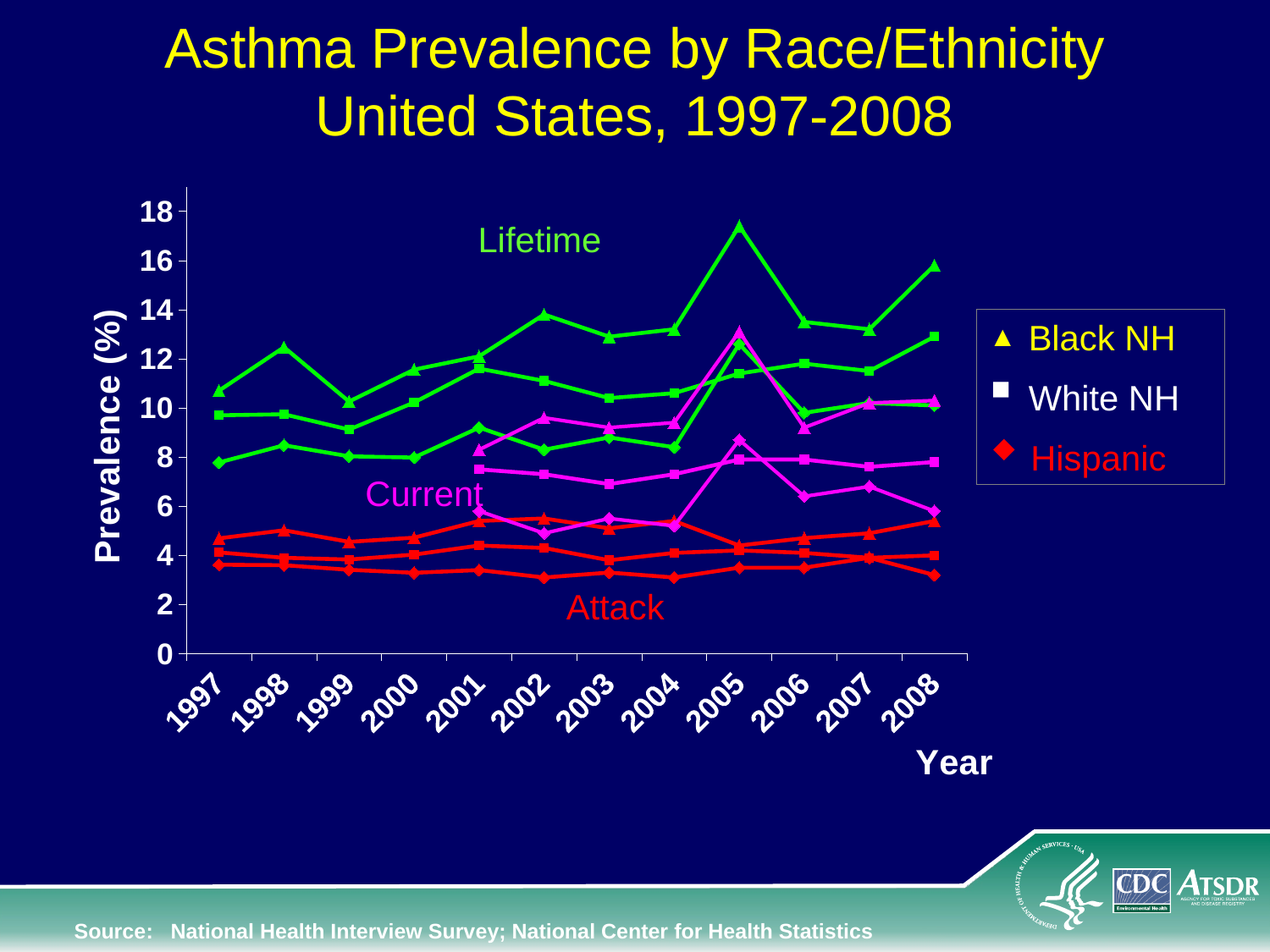
Does the Lifetime prevalence for White NH rise or fall overall from 1997 to 2008? rise How many years are shown along the x axis? 12 Is the Lifetime prevalence for Black NH in 2005 greater or less than 16? greater Is the Attack prevalence for Hispanic in 2008 greater or less than 4? less What kind of chart is shown on the slide? line chart Is the Lifetime prevalence for Black NH in 1997 greater or less than 10? greater In which year does the Lifetime prevalence for Black NH reach its highest value? 2005 In 2005, which group has the higher Lifetime prevalence, Black NH or White NH? Black NH How many series does the legend list? 3 In which year does the Current prevalence for Black NH reach its highest value? 2005 What is the label on the y axis of the chart? Prevalence (%)